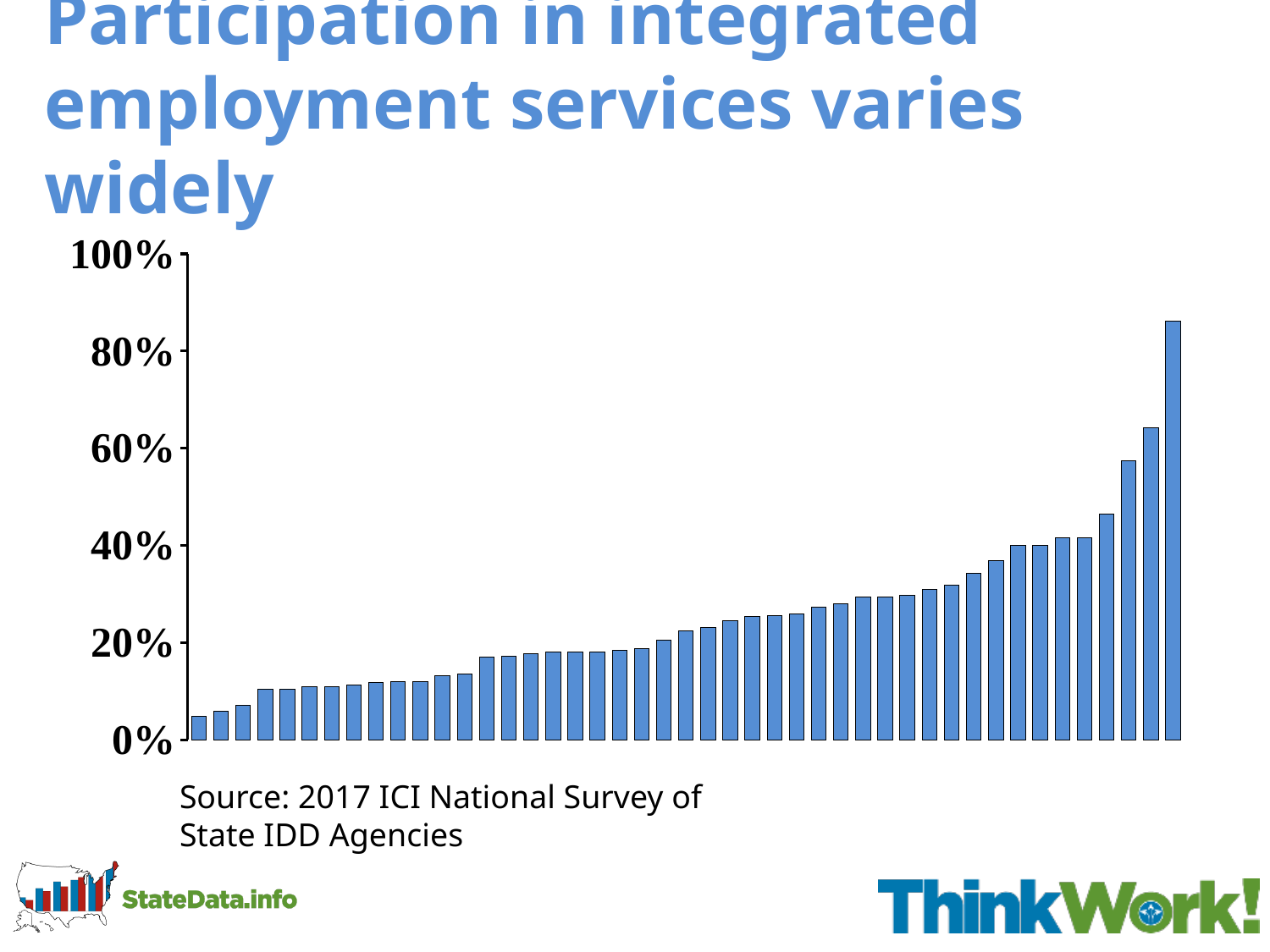
What is the highest value shown on the chart's vertical axis? 100% What is the title of the slide containing the chart? Participation in integrated employment services varies widely Is the value of the leftmost bar greater or less than 10%? less Is the value of the tallest bar greater or less than 80%? greater Where on the chart is the tallest bar located? far right Are more bars below 40% or above 40%? below Do the bar values rise or fall from left to right across the chart? rise Is the value of the shortest bar greater or less than 20%? less What kind of chart is shown on the slide? bar chart Where on the chart is the shortest bar located? far left